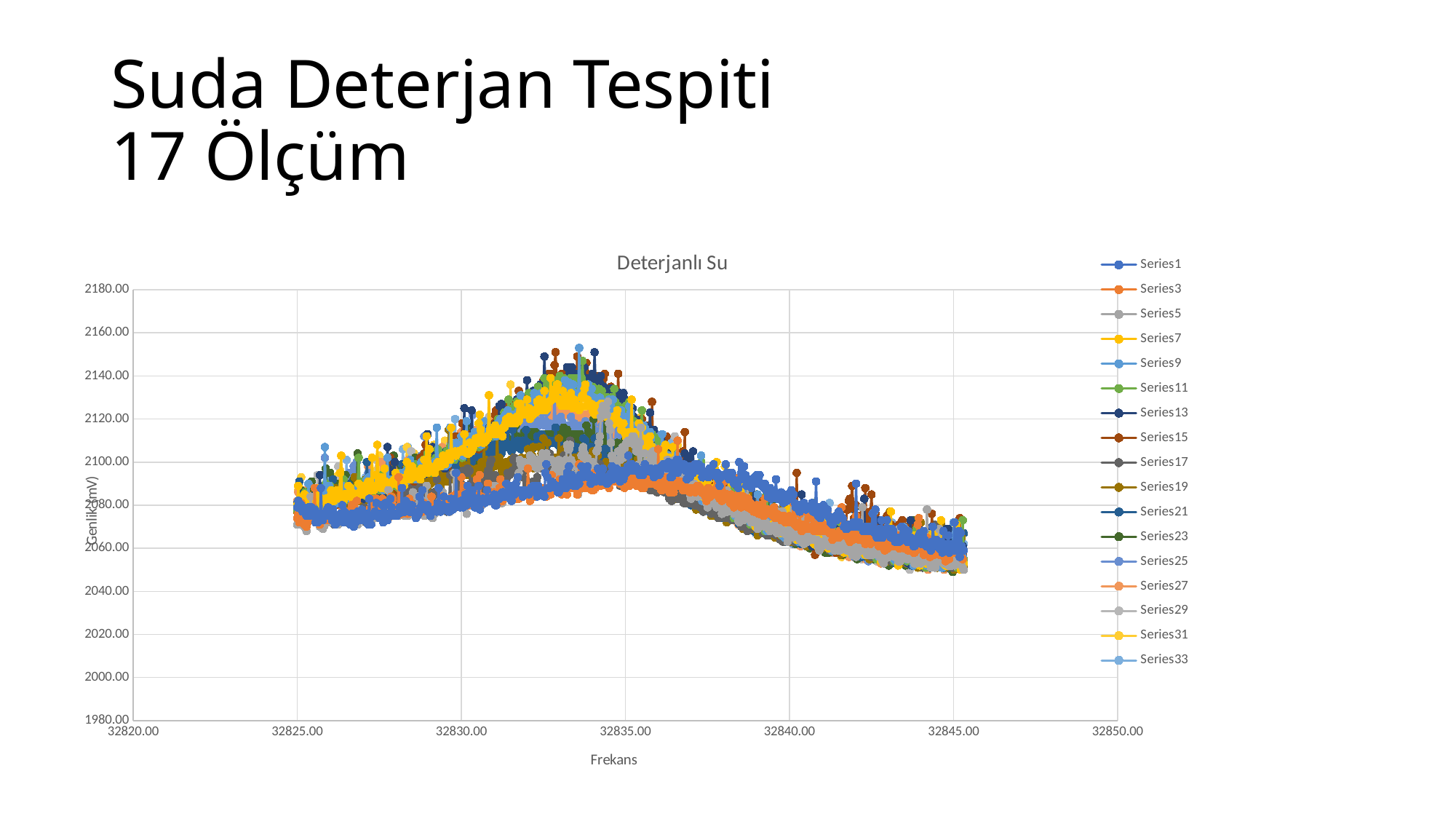
What is the title of the chart? Deterjanlı Su How many series does the chart legend list? 17 Is the highest plotted value on the chart greater or less than 2160.00? less Do the plotted values rise or fall along the x axis between 32835.00 and 32845.00? fall What kind of chart is shown on the slide? line chart What is the label of the x axis? Frekans Is the lowest plotted value on the chart greater or less than 2040.00? greater Is the highest plotted value on the chart greater or less than 2140.00? greater What is the first series name listed in the legend? Series1 Do the plotted values rise or fall along the x axis between 32825.00 and 32833.00? rise